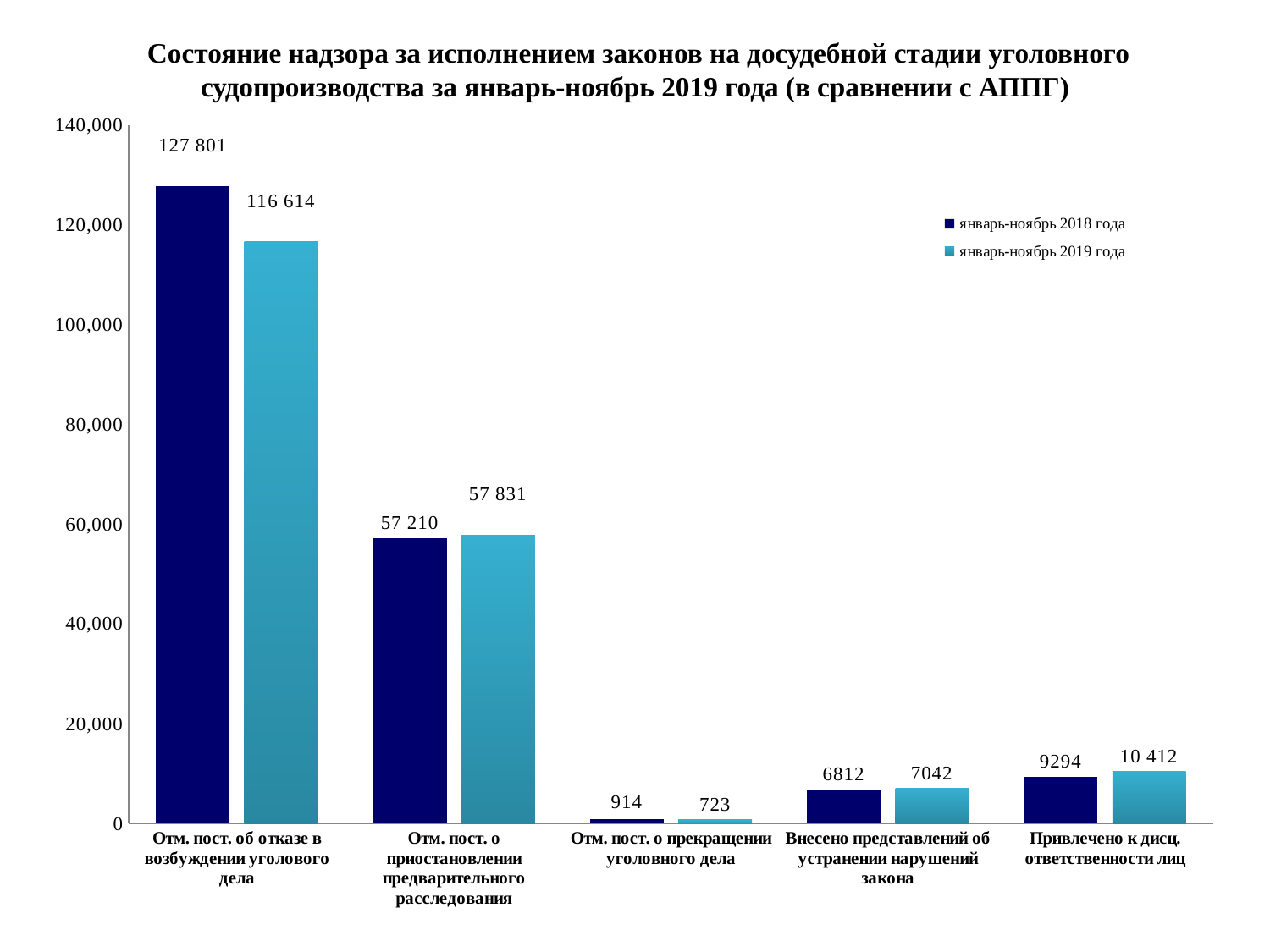
How many series does the legend list? 2 Which category has the highest value in the series "январь-ноябрь 2019 года"? Отм. пост. об отказе в возбуждении уголовного дела What is the difference between the 2019 and 2018 values for "Привлечено к дисц. ответственности лиц"? 1118 What is the value for "Привлечено к дисц. ответственности лиц" in the series "январь-ноябрь 2019 года"? 10 412 What is the value for "Внесено представлений об устранении нарушений закона" in the series "январь-ноябрь 2018 года"? 6812 What is the difference between the 2018 and 2019 values for "Отм. пост. об отказе в возбуждении уголовного дела"? 11 187 What is the value for "Отм. пост. о приостановлении предварительного расследования" in the series "январь-ноябрь 2019 года"? 57 831 How many categories are shown on the x axis? 5 What is the value for "Отм. пост. об отказе в возбуждении уголовного дела" in the series "январь-ноябрь 2018 года"? 127 801 What kind of chart is shown on the slide? Bar chart For "Отм. пост. о прекращении уголовного дела", which series has the larger value: "январь-ноябрь 2018 года" or "январь-ноябрь 2019 года"? январь-ноябрь 2018 года Which category has the lowest value in the series "январь-ноябрь 2018 года"? Отм. пост. о прекращении уголовного дела